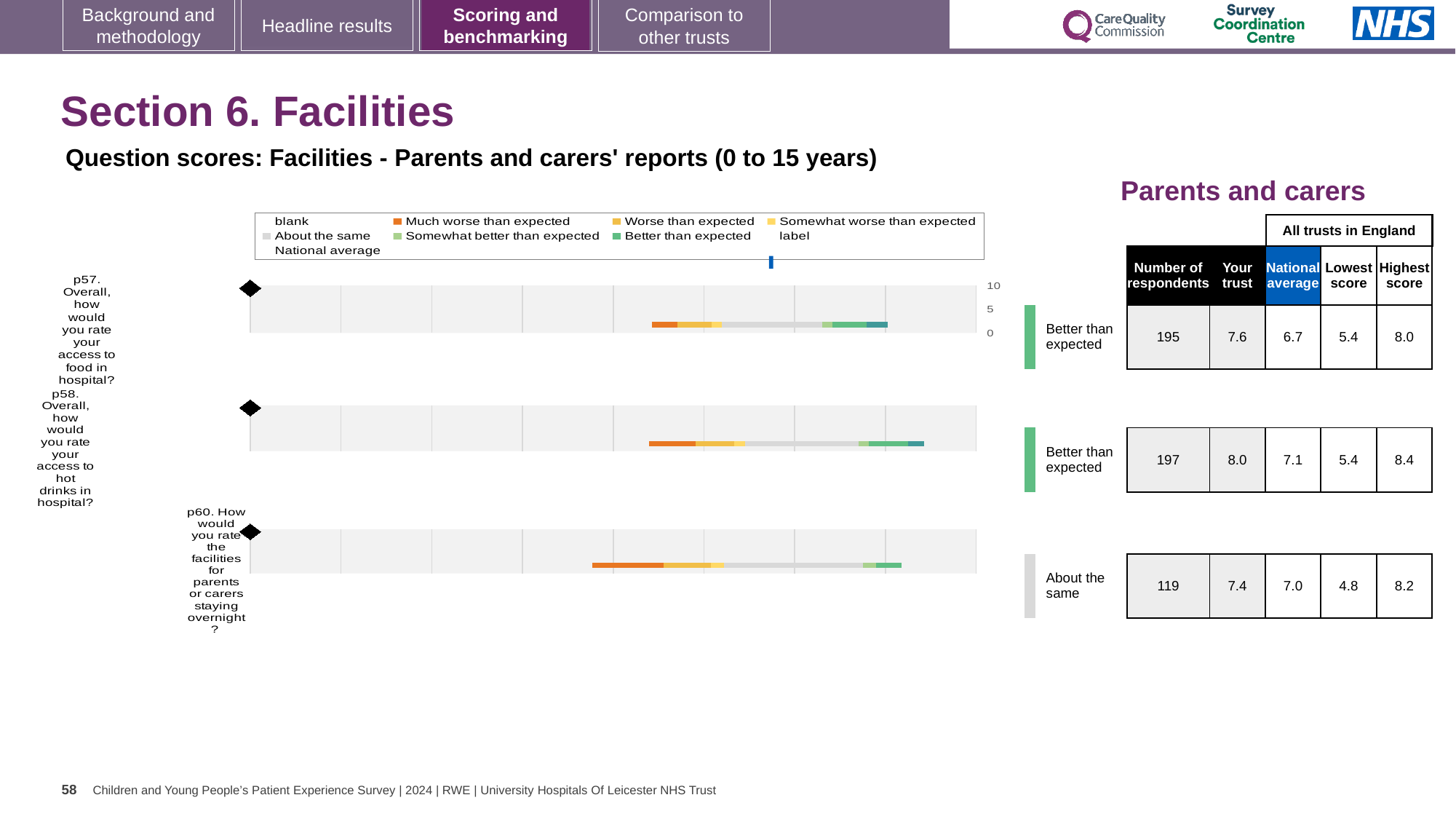
Which question has the highest 'Your trust' score? p58 What is the national average score for p58 (access to hot drinks in hospital)? 7.1 What is the lowest score across all trusts in England for p60? 4.8 What kind of chart is used to show the question scores for Facilities? bar chart How many respondents answered p60 (facilities for parents or carers staying overnight)? 119 What is the highest score across all trusts in England for p58? 8.4 How many questions are plotted in the Facilities question scores chart? 3 What benchmark category is shown for p60 (facilities for parents or carers staying overnight)? About the same For p60, which is larger: the trust score or the national average? Your trust Which question has the fewest respondents? p60 What is the 'Your trust' score for p57 (access to food in hospital)? 7.6 What is the difference between the trust score and the national average for p57? 0.9